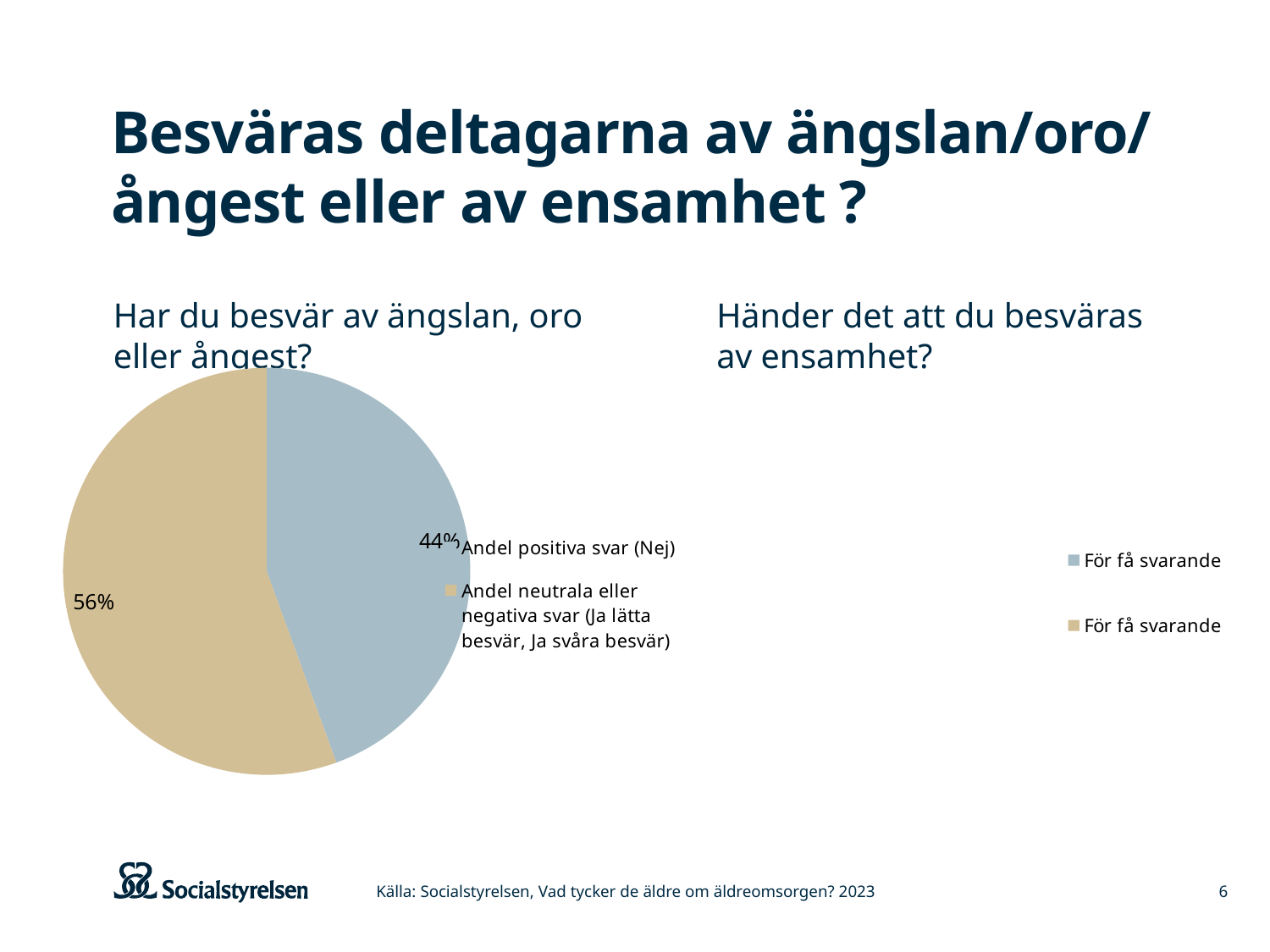
In the left chart 'Har du besvär av ängslan, oro eller ångest?', which is larger: 'Andel positiva svar (Nej)' or 'Andel neutrala eller negativa svar'? Andel neutrala eller negativa svar In the left chart 'Har du besvär av ängslan, oro eller ångest?', what colour is the 'Andel positiva svar (Nej)' slice? Blue In the left chart 'Har du besvär av ängslan, oro eller ångest?', which category has the largest slice? Andel neutrala eller negativa svar (Ja lätta besvär, Ja svåra besvär) In the left chart 'Har du besvär av ängslan, oro eller ångest?', which category has the smallest slice? Andel positiva svar (Nej) In the left chart 'Har du besvär av ängslan, oro eller ångest?', what is the difference in percentage points between the two slices? 12 In the left chart 'Har du besvär av ängslan, oro eller ångest?', what share of the pie is 'Andel positiva svar (Nej)'? 44% How many slices does the left pie chart 'Har du besvär av ängslan, oro eller ångest?' have? 2 In the left chart 'Har du besvär av ängslan, oro eller ångest?', what share of the pie is 'Andel neutrala eller negativa svar (Ja lätta besvär, Ja svåra besvär)'? 56% What type of chart is the left chart 'Har du besvär av ängslan, oro eller ångest?'? Pie chart In the left chart 'Har du besvär av ängslan, oro eller ångest?', is the share for 'Andel positiva svar (Nej)' greater or less than 50%? less What do the legend entries of the right chart 'Händer det att du besväras av ensamhet?' say? För få svarande